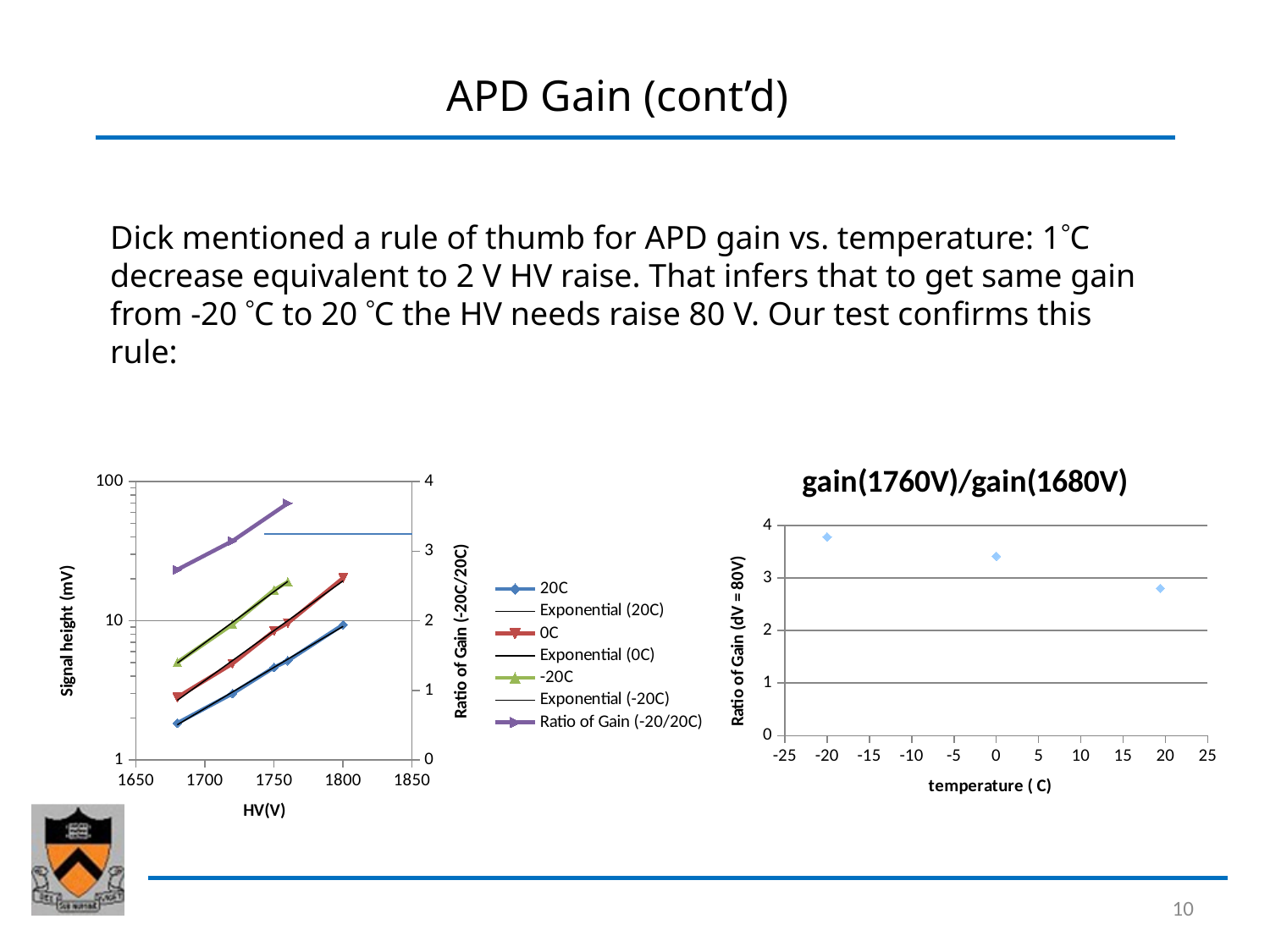
On the left chart of Signal height vs HV, is the signal height for 0C at 1800 V greater or less than 10 mV? greater On the left chart of Signal height vs HV, what is the x-axis label? HV(V) On the right chart titled gain(1760V)/gain(1680V), is the ratio of gain at -20 C greater or less than 3? greater On the right chart titled gain(1760V)/gain(1680V), does the ratio of gain rise or fall as temperature increases? fall On the left chart of Signal height vs HV, how many entries does the legend list? 7 On the left chart of Signal height vs HV, at 1760 V, which series has the larger signal height, -20C or 20C? -20C On the left chart of Signal height vs HV, does the signal height rise or fall as HV increases? rise On the right chart titled gain(1760V)/gain(1680V), at which temperature is the ratio of gain highest? -20 On the right chart titled gain(1760V)/gain(1680V), how many data points are plotted? 3 On the right chart titled gain(1760V)/gain(1680V), what is the x-axis label? temperature ( C) On the right chart titled gain(1760V)/gain(1680V), is the ratio of gain at 20 C greater or less than 3? less